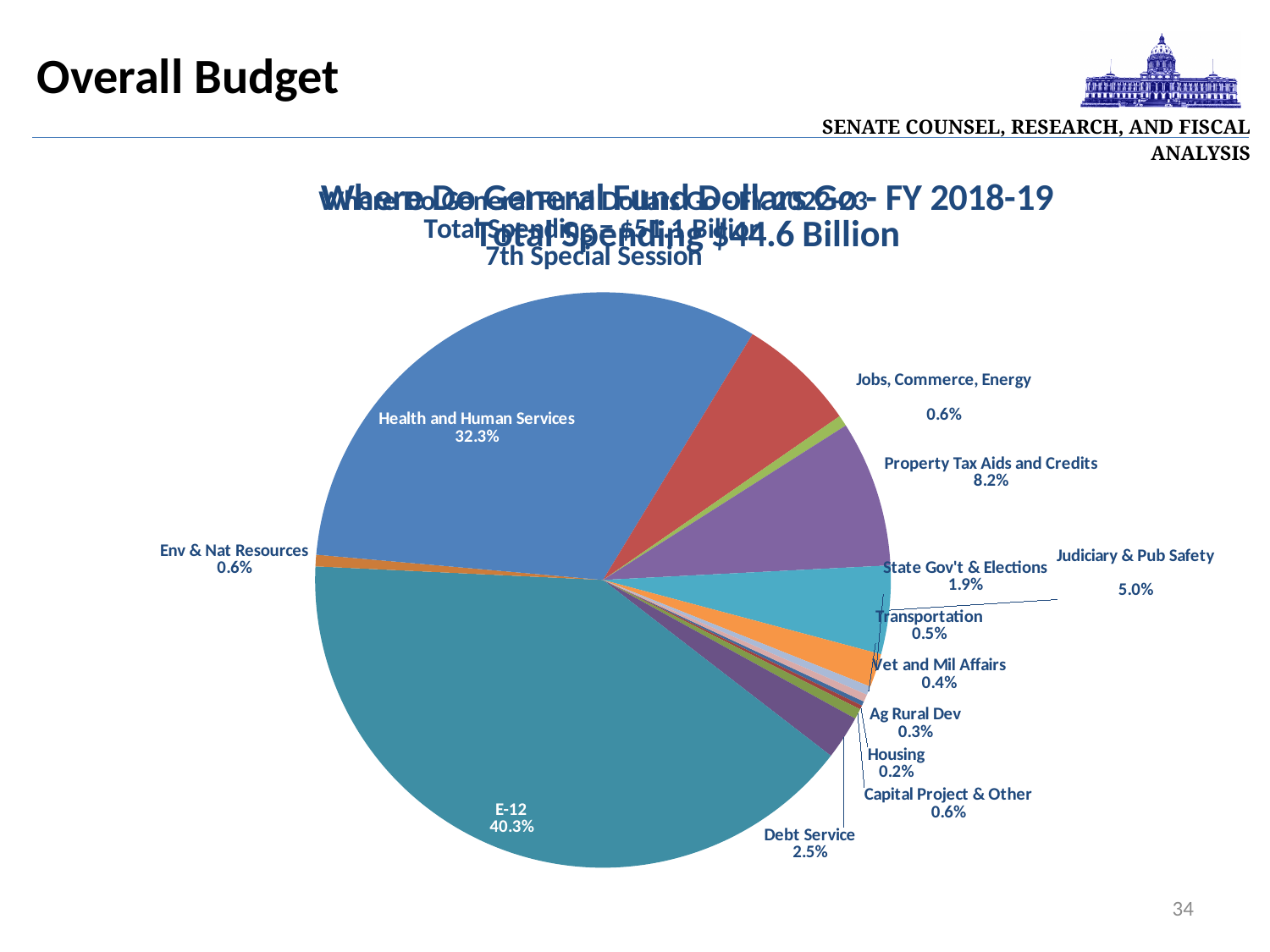
How many categories are labeled on the pie chart? 13 What percentage is shown for Property Tax Aids and Credits? 8.2% Which category has the largest share of the pie? E-12 How many percentage points larger is the E-12 share than the Health and Human Services share? 8.0 percentage points Which is larger, the share for Property Tax Aids and Credits or the share for Judiciary & Pub Safety? Property Tax Aids and Credits What percentage is shown for Debt Service? 2.5% What is the combined share of E-12 and Health and Human Services? 72.6% What percentage is shown for Health and Human Services? 32.3% What percentage is shown for Judiciary & Pub Safety? 5.0% Which category has the smallest share of the pie? Housing What share of the pie does E-12 represent? 40.3% What type of chart is shown on the slide? Pie chart